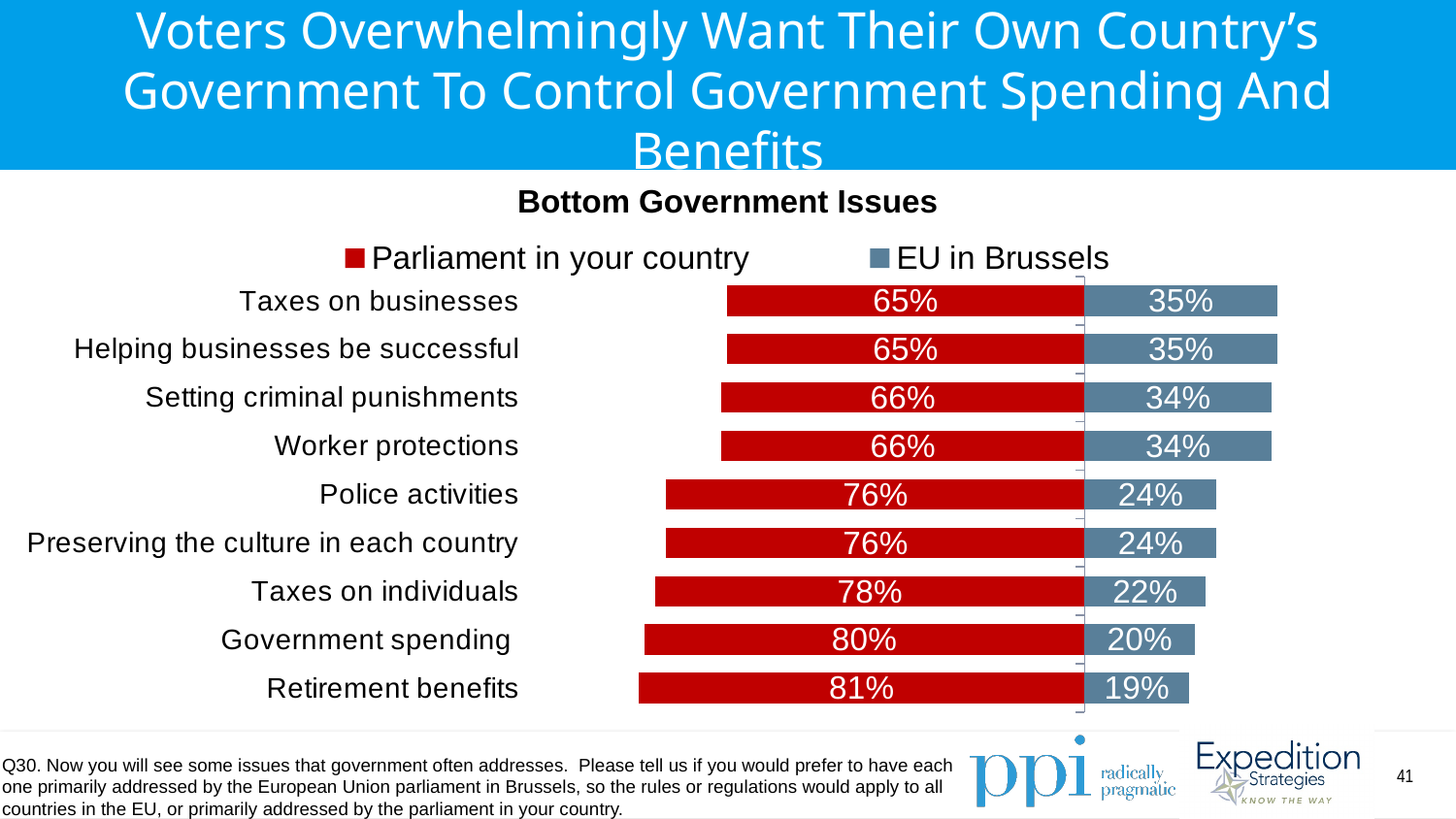
Which issue has the highest value for Parliament in your country? Retirement benefits Which is larger: the Parliament in your country value for government spending or for worker protections? Government spending How many issues are shown in the chart? 9 What is the value for Parliament in your country for police activities? 76% What kind of chart is shown on the slide? Stacked bar chart What is the difference between the Parliament in your country and EU in Brussels values for taxes on individuals? 56 percentage points Which issue has the lowest value for EU in Brussels? Retirement benefits What percentage of voters prefer the parliament in their own country to handle retirement benefits? 81% What is the title of the chart? Bottom Government Issues How many series does the legend list? 2 What is the total of the two values for setting criminal punishments? 100% What is the value for EU in Brussels for government spending? 20%